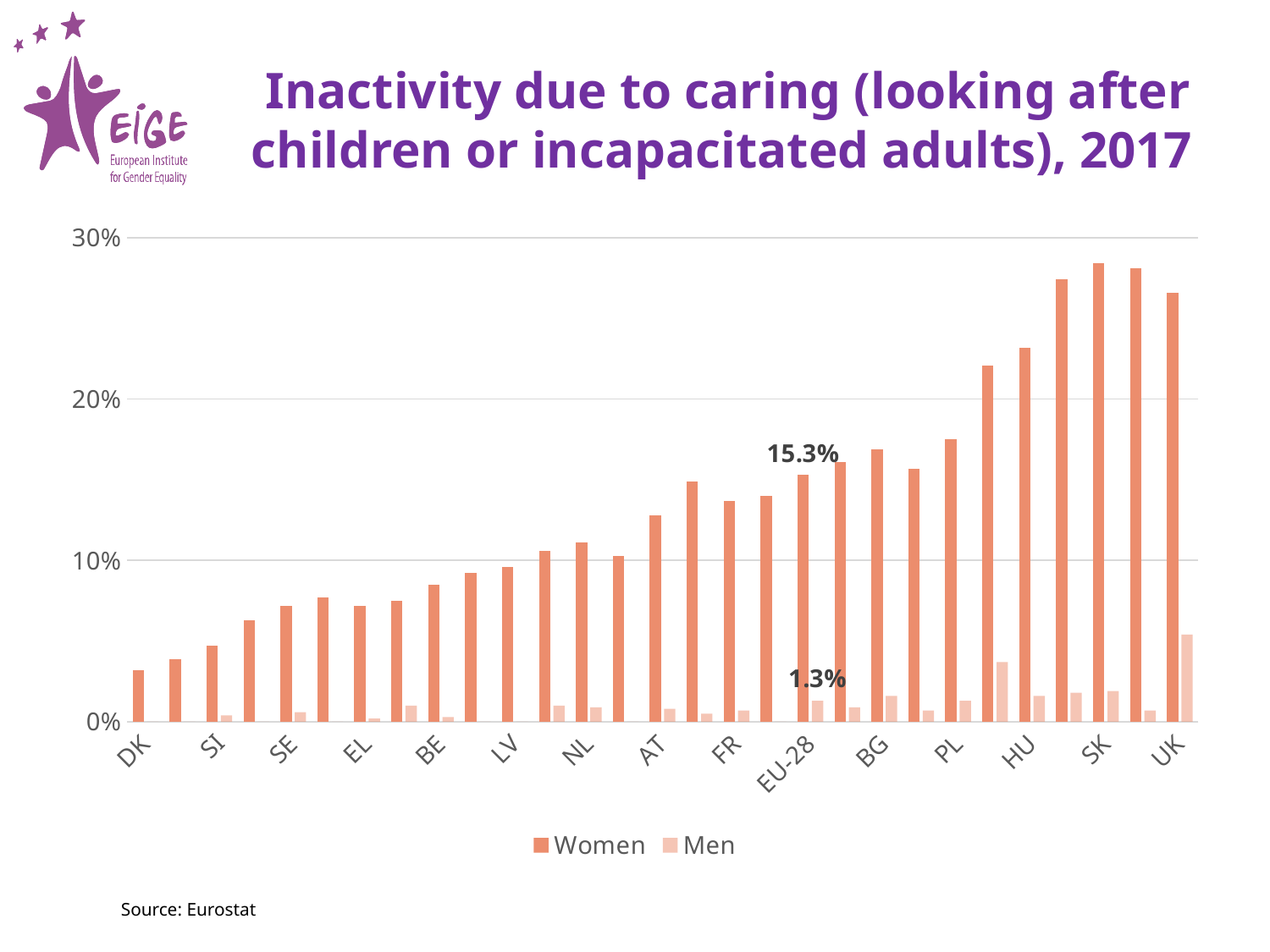
Is the Women value for UK greater or less than 20%? greater How many series does the legend list? 2 Is the Women value for DK greater or less than 10%? less What is the value for Men in EU-28? 1.3% What kind of chart is shown on the slide? Bar chart What is the value for Women in EU-28? 15.3% Which has the higher Women value, SK or UK? SK Which of the labelled countries has the lowest Women value? DK What is the difference between the Women and Men values for EU-28? 14.0% For EU-28, which series has the larger value, Women or Men? Women Is the Men value for HU greater or less than 10%? less Do the Women values generally rise or fall from left to right along the x axis? Rise